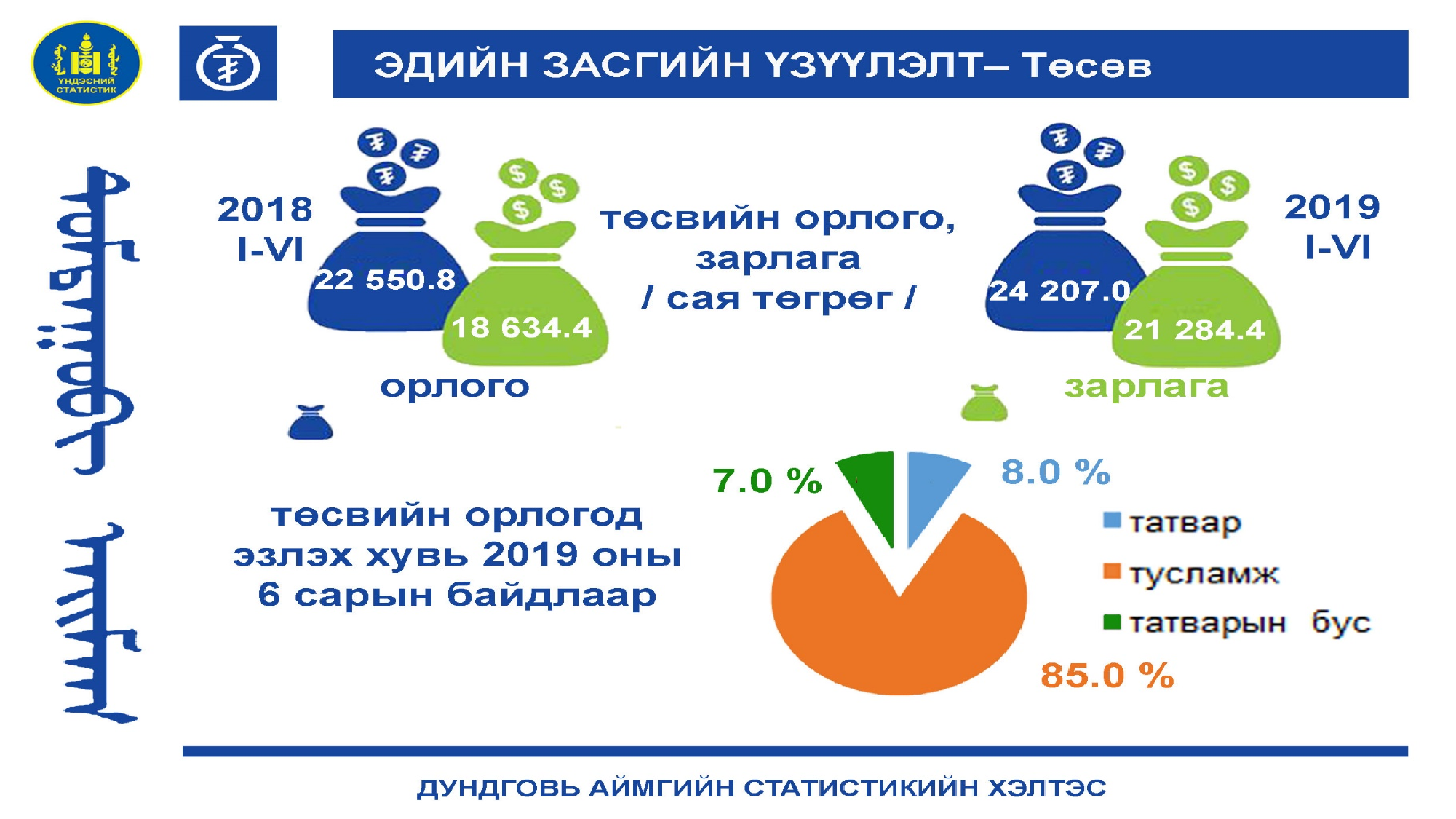
Which slice of the pie chart is the smallest? татварын бус In the pie chart, what share does тусламж have? 85.0 % In the money-bag infographic at the top of the slide, what is the орлого value for 2019 I-VI? 24 207.0 What colour is the тусламж slice in the pie chart? orange How many entries does the pie chart legend list? 3 In the pie chart, what share does татвар have? 8.0 % How many slices does the pie chart have? 3 What kind of chart is shown at the bottom right of the slide? pie chart Which slice of the pie chart is the largest? тусламж In the pie chart, what share does татварын бус have? 7.0 % In the pie chart, which is larger: the share of татвар or the share of татварын бус? татвар In the pie chart, what is the difference between the share of тусламж and the share of татвар? 77.0 %